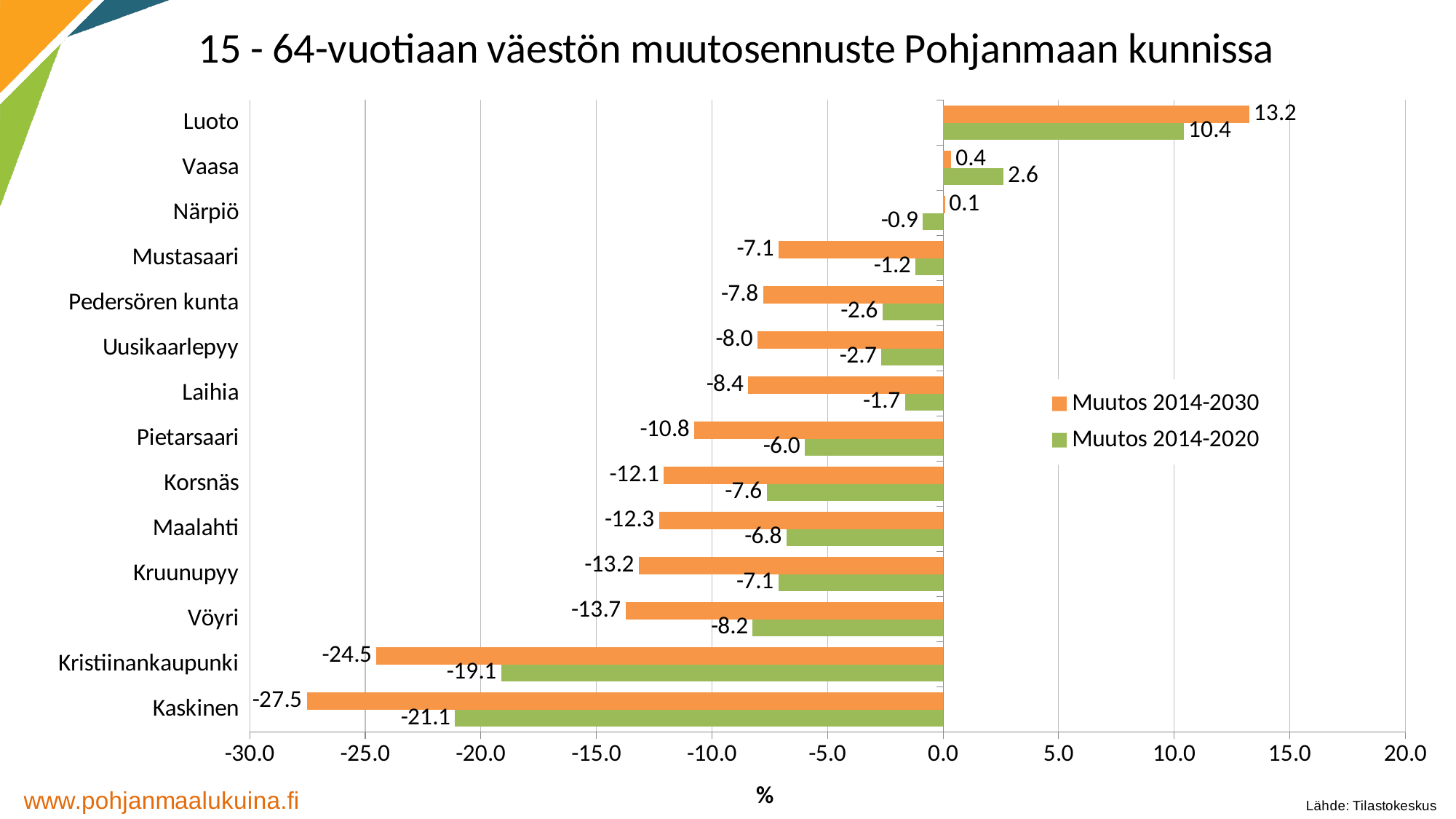
What is the difference between the Muutos 2014-2030 and Muutos 2014-2020 values for Kristiinankaupunki? 5.4 Which is larger for Vaasa: the Muutos 2014-2030 value or the Muutos 2014-2020 value? Muutos 2014-2020 What is the Muutos 2014-2020 value for Pietarsaari? -6.0 How many municipalities are shown on the chart? 14 Which municipality has the lowest Muutos 2014-2020 value? Kaskinen How many series does the legend list? 2 What is the title of the chart? 15 - 64-vuotiaan väestön muutosennuste Pohjanmaan kunnissa Which municipality has the highest Muutos 2014-2030 value? Luoto Is the Muutos 2014-2030 value for Vöyri greater or less than -10.0? less What kind of chart is shown on the slide? Bar chart What is the Muutos 2014-2030 value for Kaskinen? -27.5 What is the Muutos 2014-2020 value for Luoto? 10.4